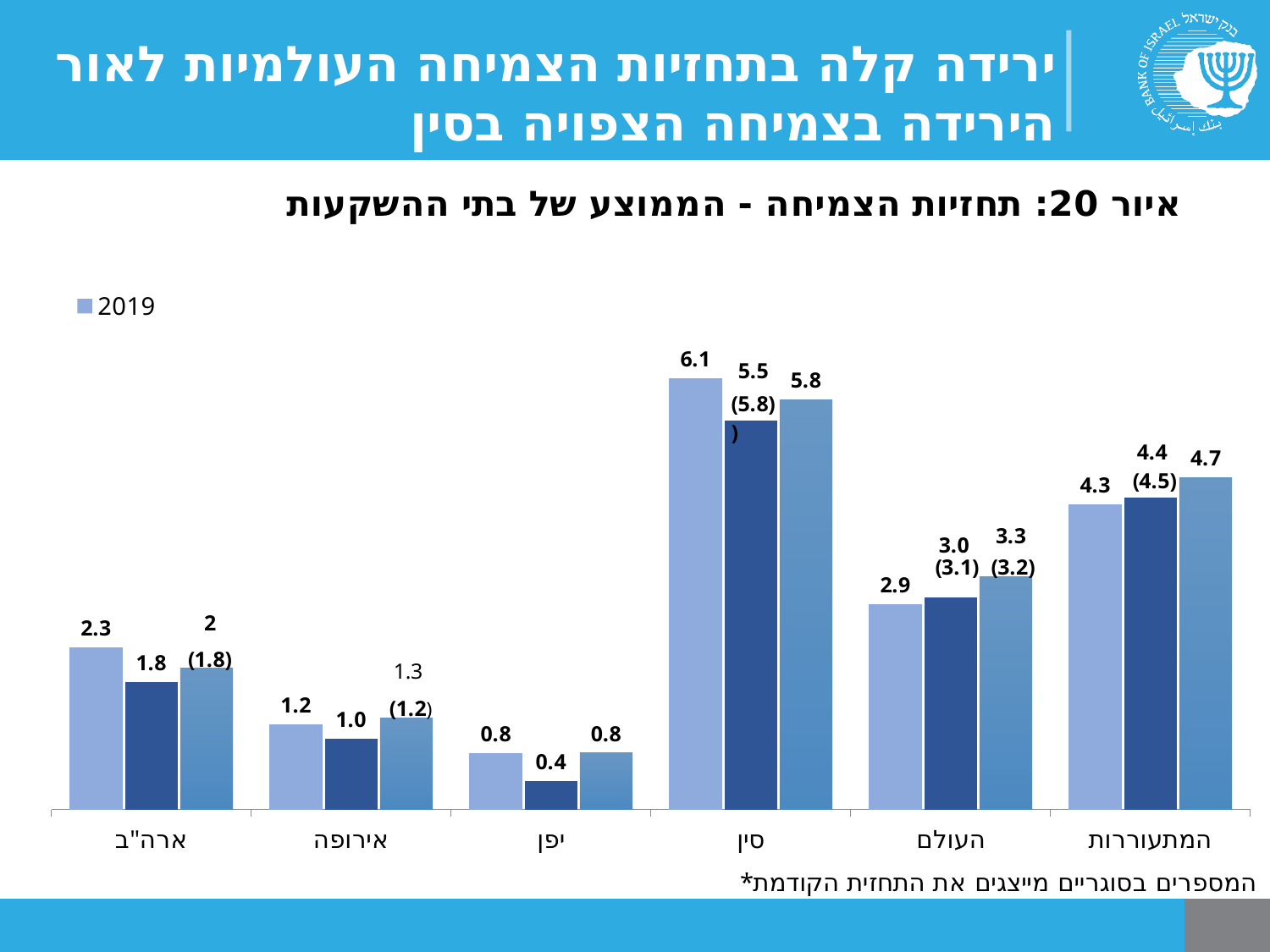
What kind of chart is shown on the slide? Bar chart What is the value of the middle (dark blue) bar for יפן (Japan)? 0.4 Which has a larger 2019 value, ארה"ב or אירופה? ארה"ב What is the 2019 value for יפן (Japan)? 0.8 Which category has the highest 2019 value? סין What is the 2019 value for סין (China)? 6.1 What previous forecast is shown in parentheses for the middle bar of סין (China)? (5.8) What is the title of the chart? איור 20: תחזיות הצמיחה - הממוצע של בתי ההשקעות How many categories are shown on the x axis? 6 Which category has the lowest 2019 value? יפן What is the difference between the 2019 value for סין (6.1) and the 2019 value for המתעוררות (4.3)? 1.8 What is the value of the rightmost bar in the המתעוררות (emerging markets) group? 4.7